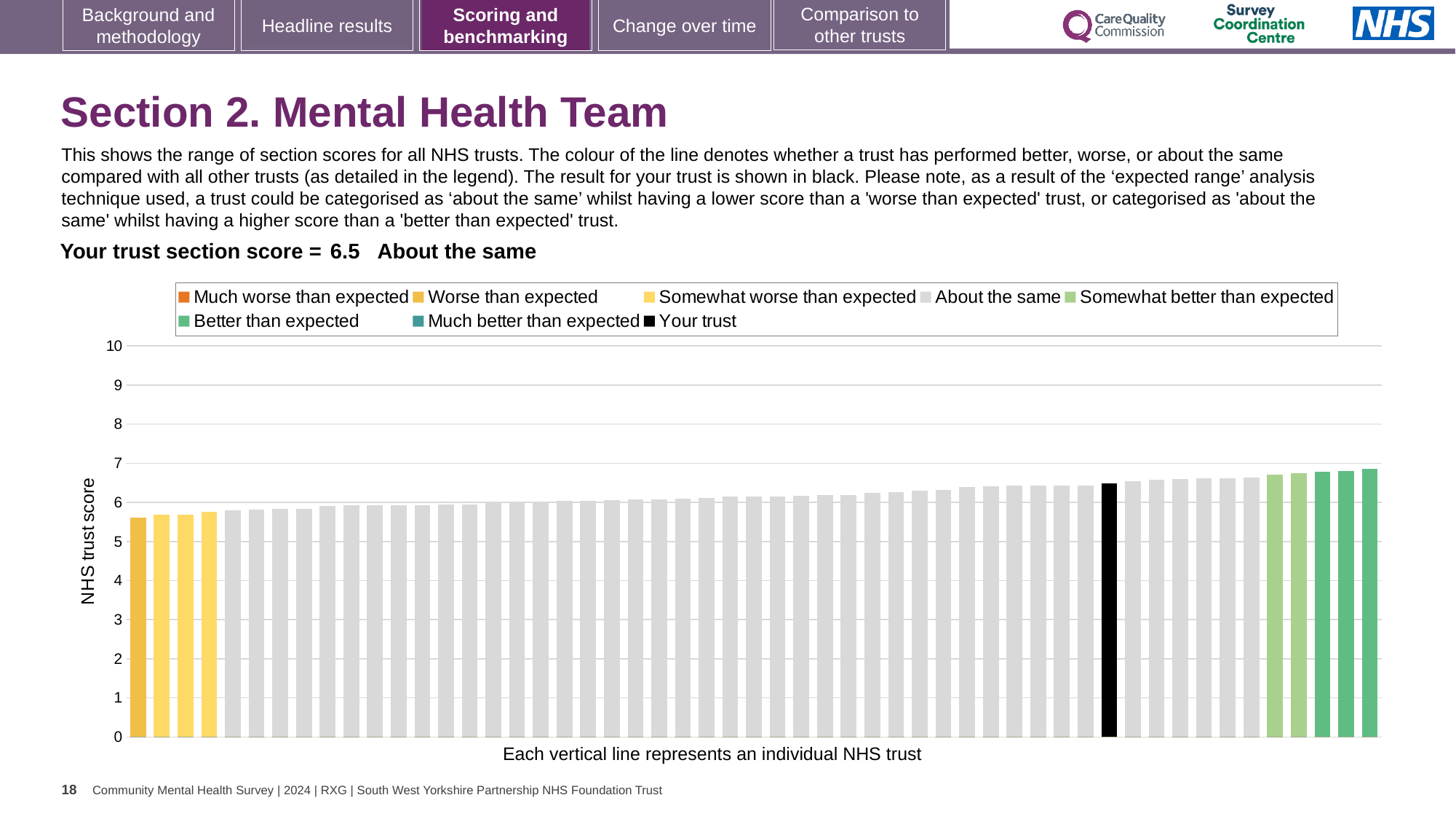
Is the value for your trust (the black bar) greater or less than 6? greater What is the label on the vertical axis of the chart? NHS trust score How many entries does the chart legend list? 8 Is the value for the rightmost (highest) bar greater or less than 7? less Which is larger, the value for your trust (black bar) or the value for the leftmost bar? your trust Is the value for the leftmost (lowest) bar greater or less than 6? less How is your trust categorised relative to other trusts for this section? About the same What kind of chart is shown on the slide? bar chart What is the highest value shown on the vertical axis? 10 Do the bar values rise or fall moving from left to right along the x axis? rise What is the section score for your trust shown on the slide? 6.5